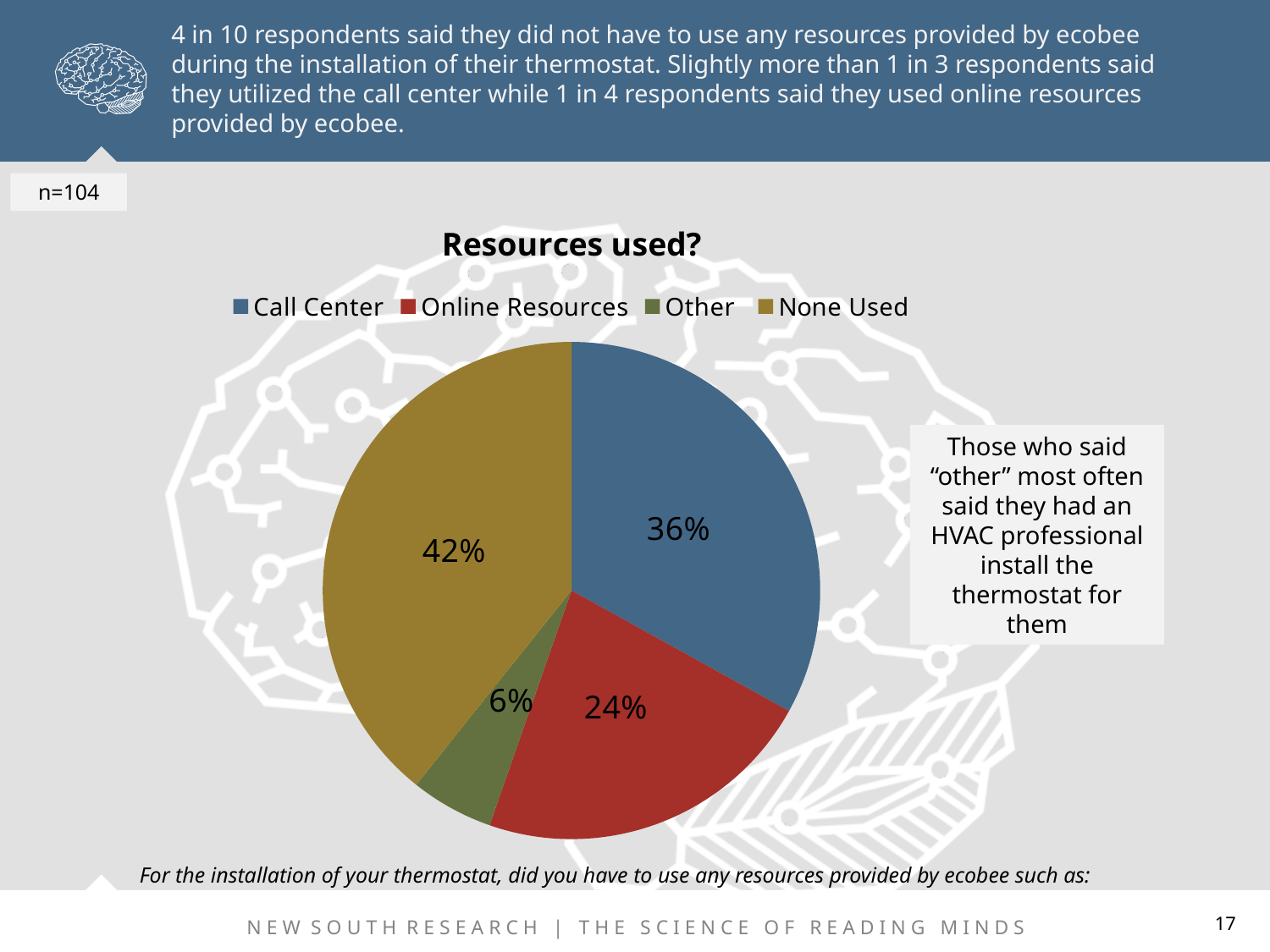
Which category has the largest share of the pie? None Used What percentage of respondents used Online Resources? 24% What percentage of respondents selected Other? 6% What type of chart is shown on the slide? pie chart How many categories does the pie chart show? 4 What is the difference in percentage points between None Used and Call Center? 6 Which category is shown in red in the legend? Online Resources Which is larger, the share for Call Center or the share for Online Resources? Call Center What percentage of respondents used the Call Center? 36% Which category has the smallest share of the pie? Other What is the title of the chart? Resources used? What percentage of respondents said None Used? 42%